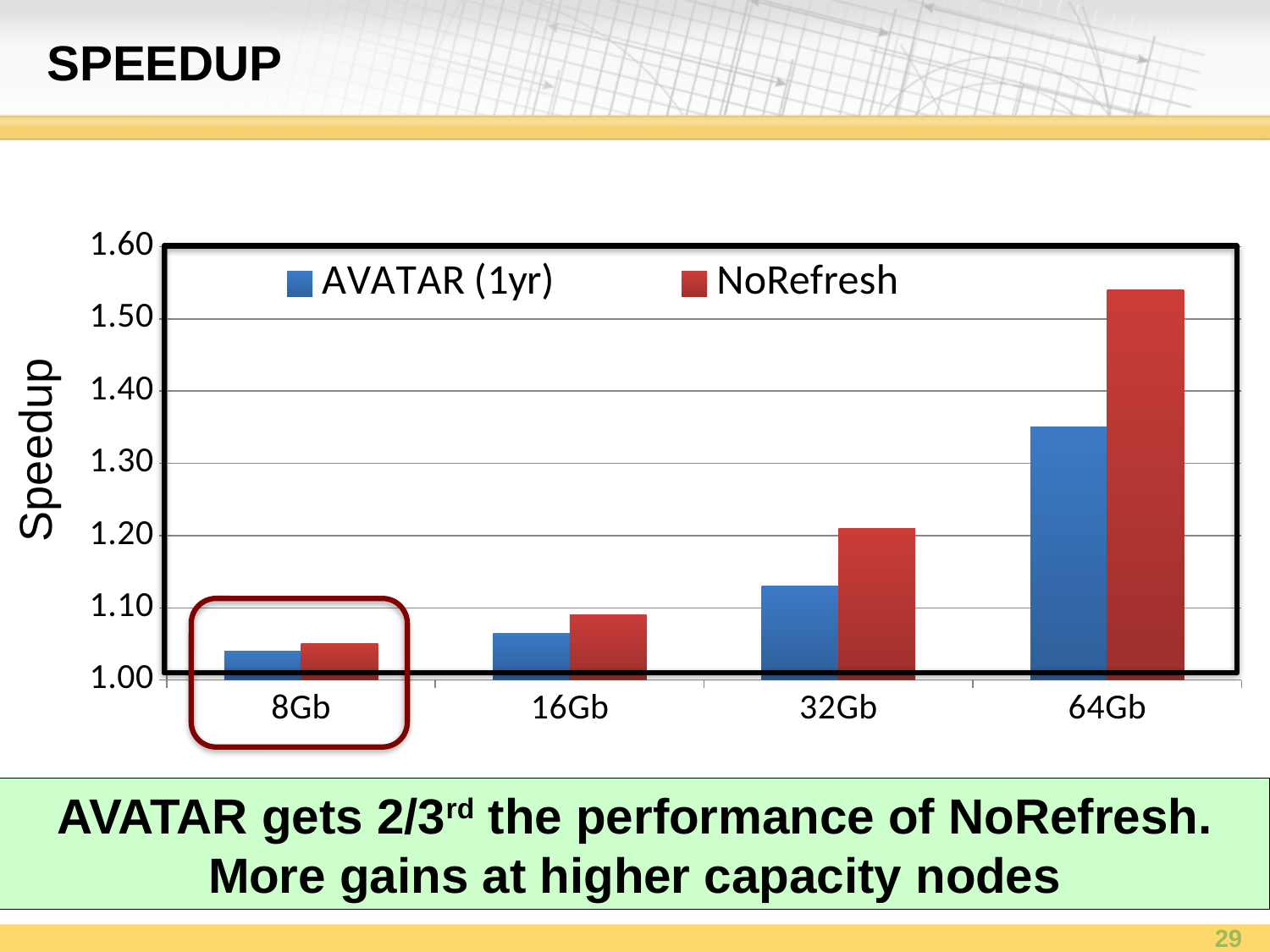
What is the label on the y axis of the chart? Speedup At 64Gb, which series has the larger speedup, AVATAR (1yr) or NoRefresh? NoRefresh How many series does the legend list? 2 What kind of chart is shown on the slide? bar chart How many capacity categories are shown on the x axis? 4 Which is larger: the AVATAR (1yr) speedup at 64Gb or the NoRefresh speedup at 32Gb? AVATAR (1yr) at 64Gb Which category has the lowest AVATAR (1yr) speedup? 8Gb Which category has the highest NoRefresh speedup? 64Gb Is the NoRefresh speedup at 64Gb greater or less than 1.50? greater Is the AVATAR (1yr) speedup at 16Gb greater or less than 1.10? less Do the speedup values rise or fall as capacity increases from 8Gb to 64Gb? rise Is the AVATAR (1yr) speedup at 64Gb greater or less than 1.30? greater